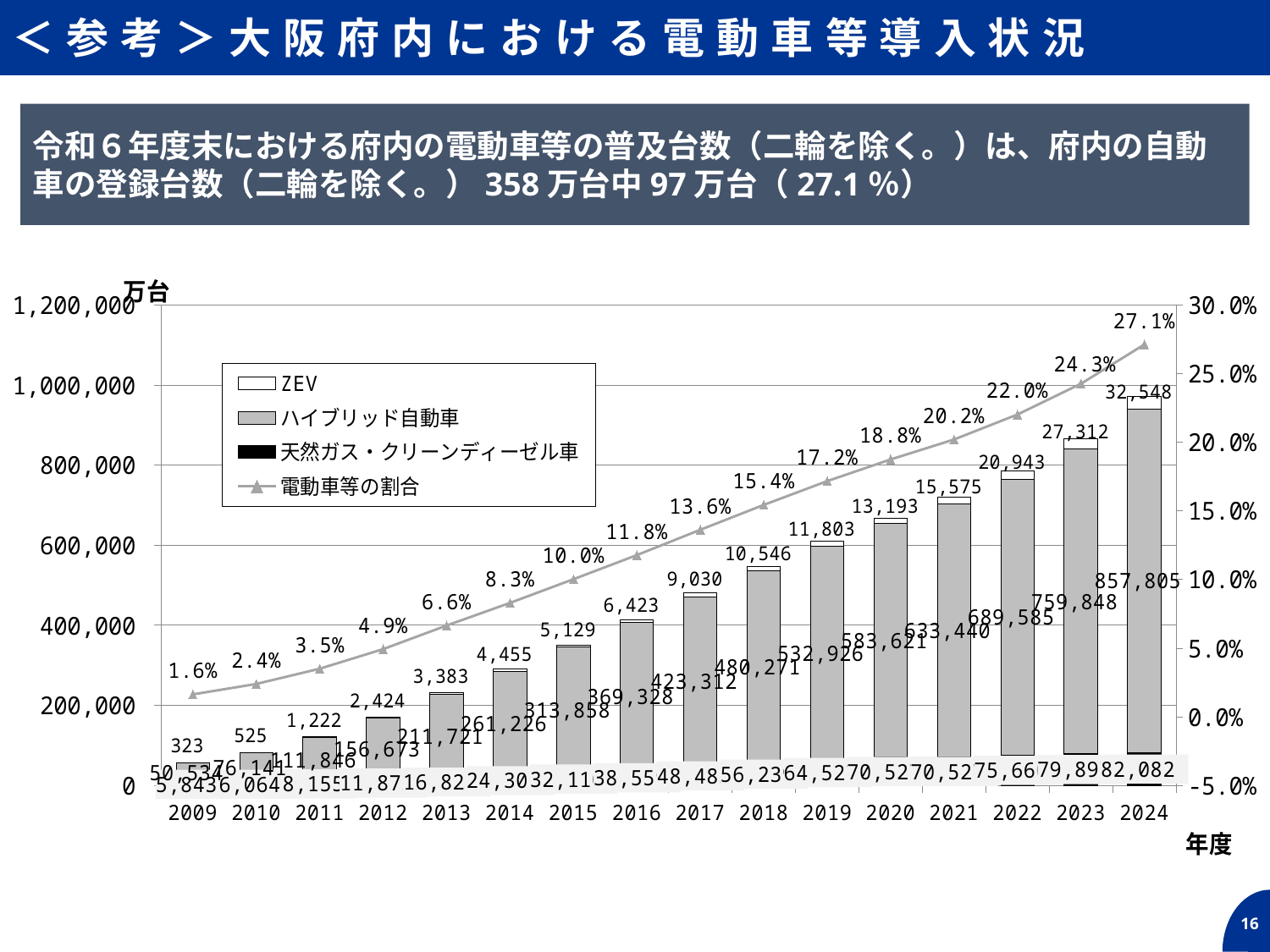
What is the difference between the 電動車等の割合 for 2024 and 2023? 2.8% How many years are shown on the x axis? 16 What is the difference between the ZEV values for 2024 and 2023? 5,236 Which is larger, the ハイブリッド自動車 value for 2020 or for 2019? 2020 What is the ハイブリッド自動車 value for 2024? 857,805 How many series does the legend list? 4 What is the value of 電動車等の割合 for 2024? 27.1% What kind of chart is this? Combined stacked bar and line chart Which year has the highest ZEV value? 2024 What is the ZEV value for 2024? 32,548 Which year has the lowest 電動車等の割合? 2009 Does the 電動車等の割合 line rise or fall from 2009 to 2024? Rise